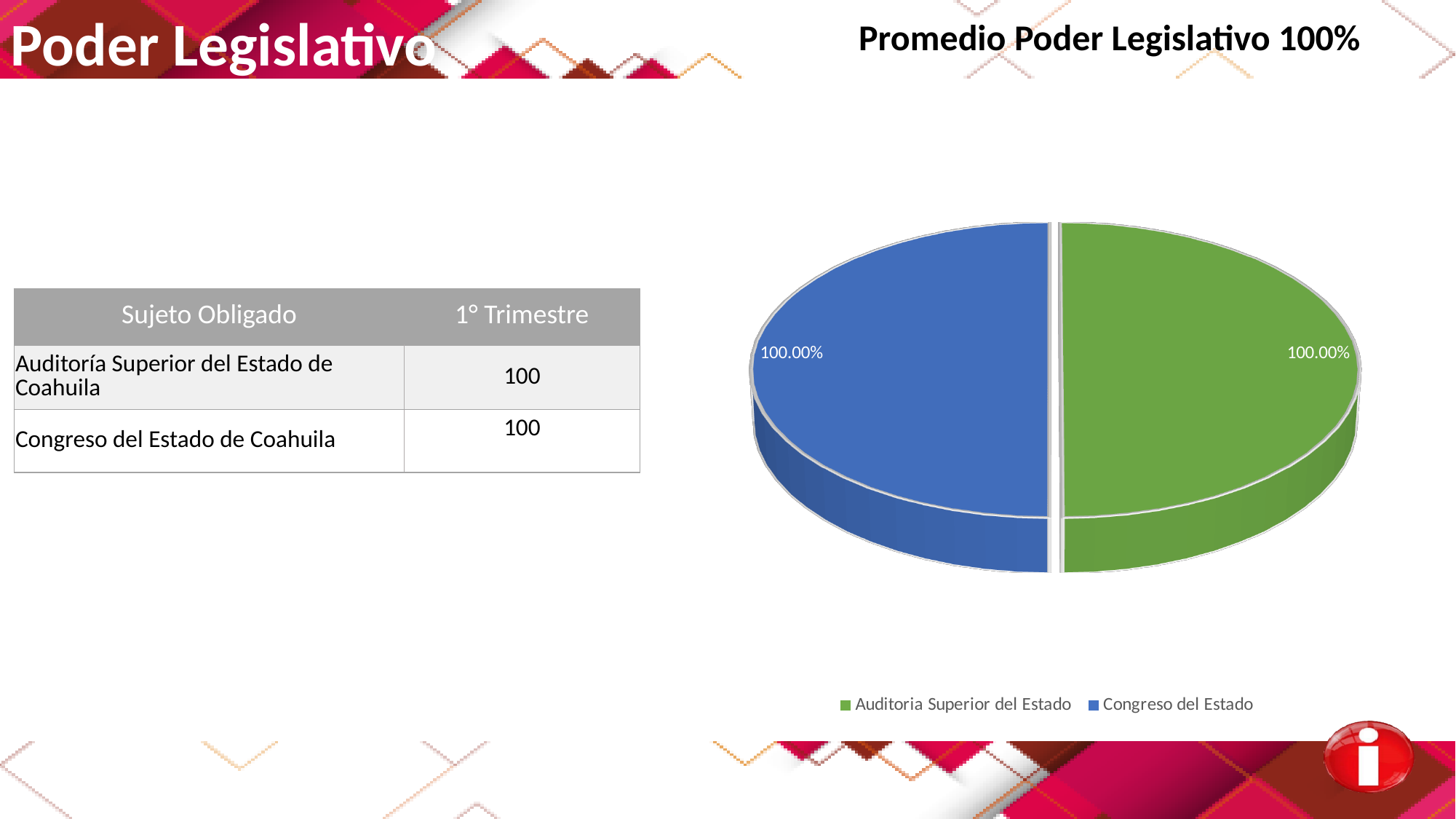
What data label is shown on the Congreso del Estado slice of the pie chart? 100.00% Which colour represents Congreso del Estado in the pie chart? Blue How many slices does the pie chart have? 2 Is the data label on the Congreso del Estado slice greater or less than 50%? greater How many entries does the legend of the pie chart list? 2 What kind of chart is shown on the slide? Pie chart What data label is shown on the Auditoria Superior del Estado slice of the pie chart? 100.00% Which legend entry is listed first in the pie chart's legend? Auditoria Superior del Estado Which colour represents Auditoria Superior del Estado in the pie chart? Green